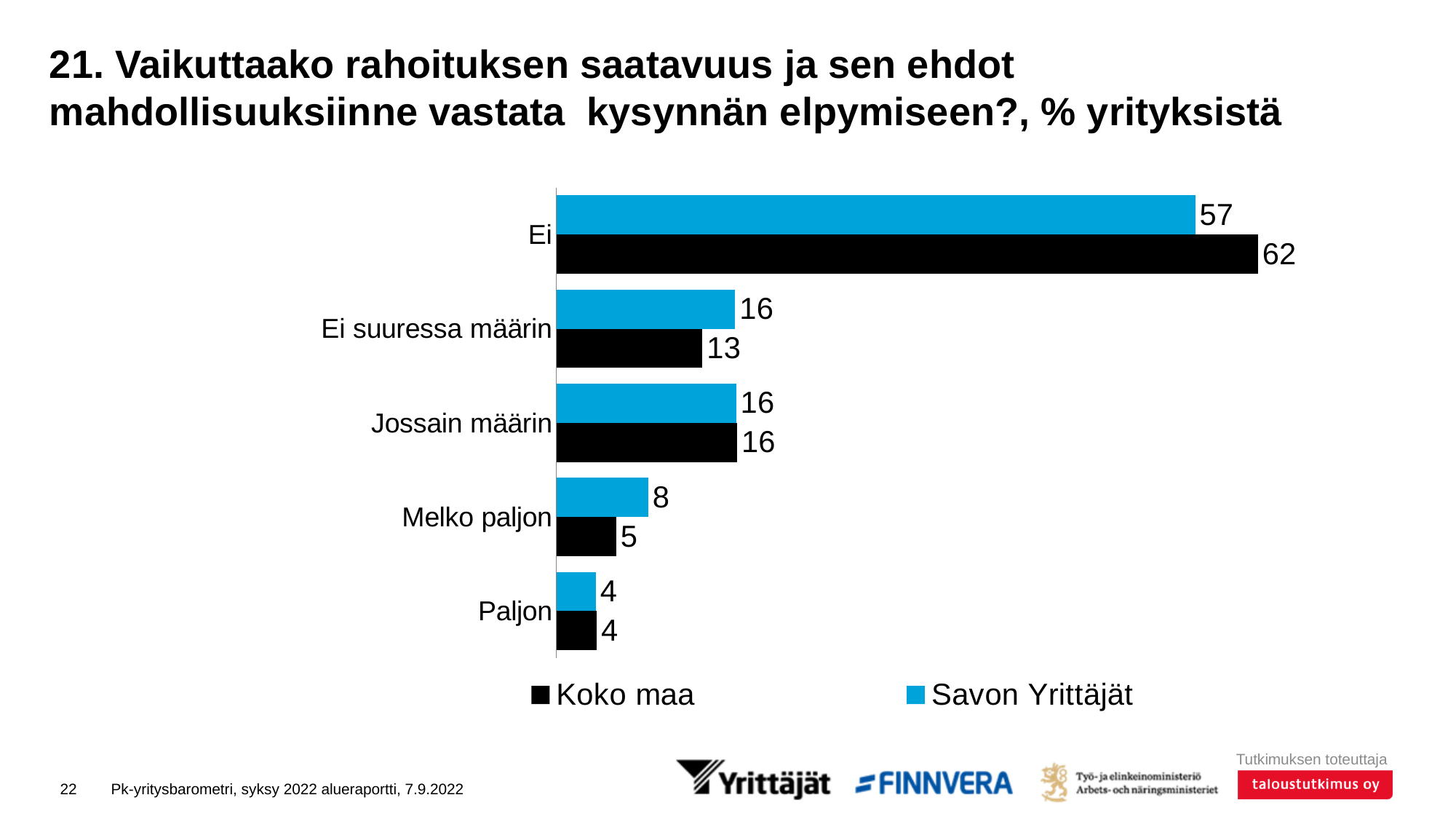
Which category has the lowest value for Savon Yrittäjät? Paljon Which is larger in the Melko paljon category, Koko maa or Savon Yrittäjät? Savon Yrittäjät Which category has the highest value for Koko maa? Ei What is the value for Koko maa in the Ei suuressa määrin category? 13 How many series does the legend list? 2 What is the value for Koko maa in the Ei category? 62 How many categories are shown on the chart? 5 What is the value for Savon Yrittäjät in the Ei category? 57 What is the difference between Koko maa and Savon Yrittäjät in the Ei category? 5 What is the value for Savon Yrittäjät in the Melko paljon category? 8 Which colour represents Savon Yrittäjät in the chart? Blue What kind of chart is shown on the slide? Bar chart